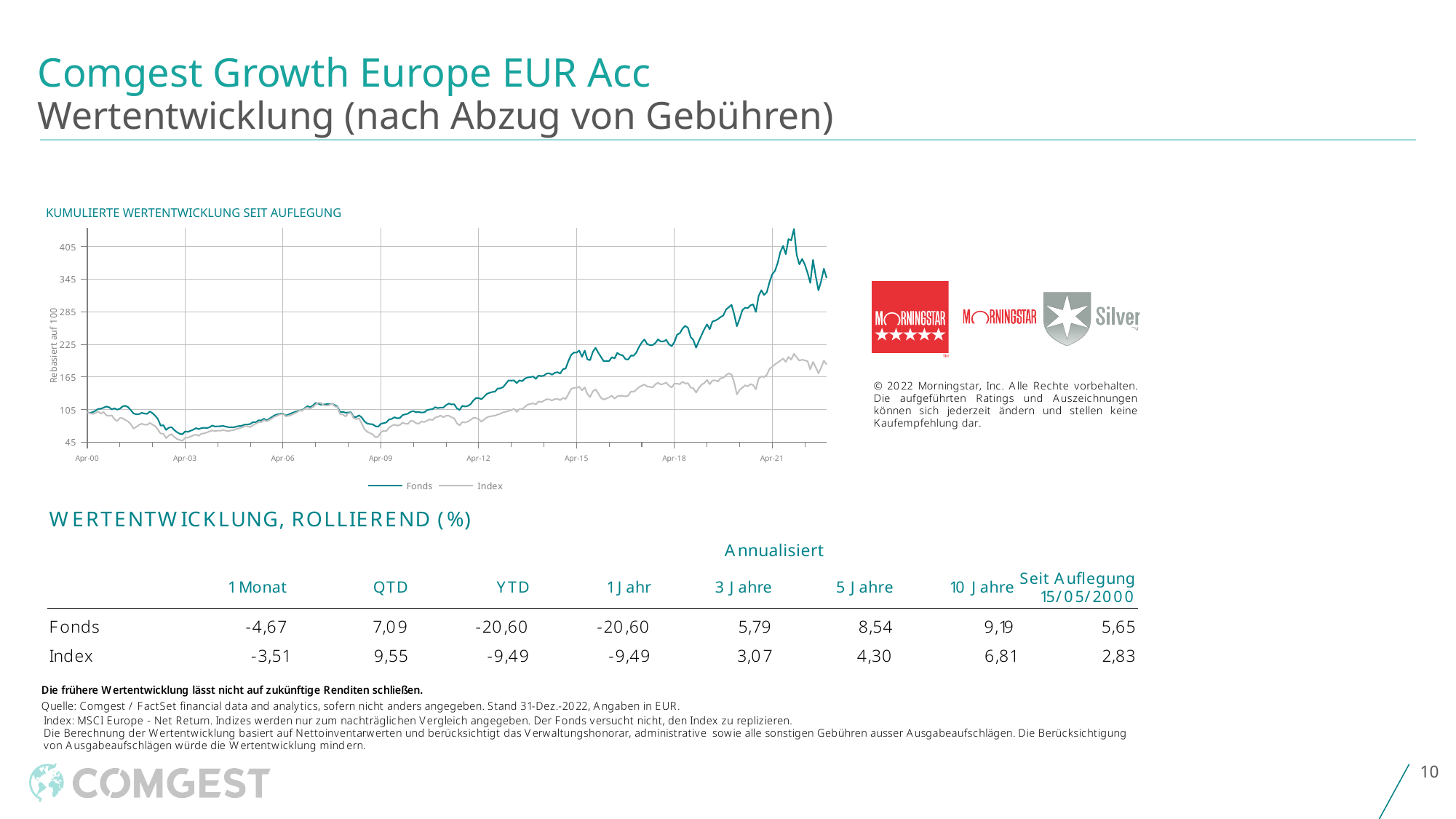
In the cumulative performance chart, is the Fonds value at the right-hand end of the chart greater or less than 285? greater In the cumulative performance chart, is the Fonds value at Apr-09 greater or less than 105? less What is the title of the line chart on the slide? KUMULIERTE WERTENTWICKLUNG SEIT AUFLEGUNG In the cumulative performance chart, which series is higher at the right-hand end of the chart, Fonds or Index? Fonds What are the two series named in the legend of the cumulative performance chart? Fonds and Index How many date labels are shown on the x axis of the cumulative performance chart? 8 How many series does the legend of the cumulative performance chart list? 2 In the cumulative performance chart, is the highest point reached by the Fonds line greater or less than 345? greater What kind of chart is shown under the heading 'KUMULIERTE WERTENTWICKLUNG SEIT AUFLEGUNG'? Line chart In the cumulative performance chart, does the Fonds line overall rise or fall from Apr-00 to the end of the chart? Rise